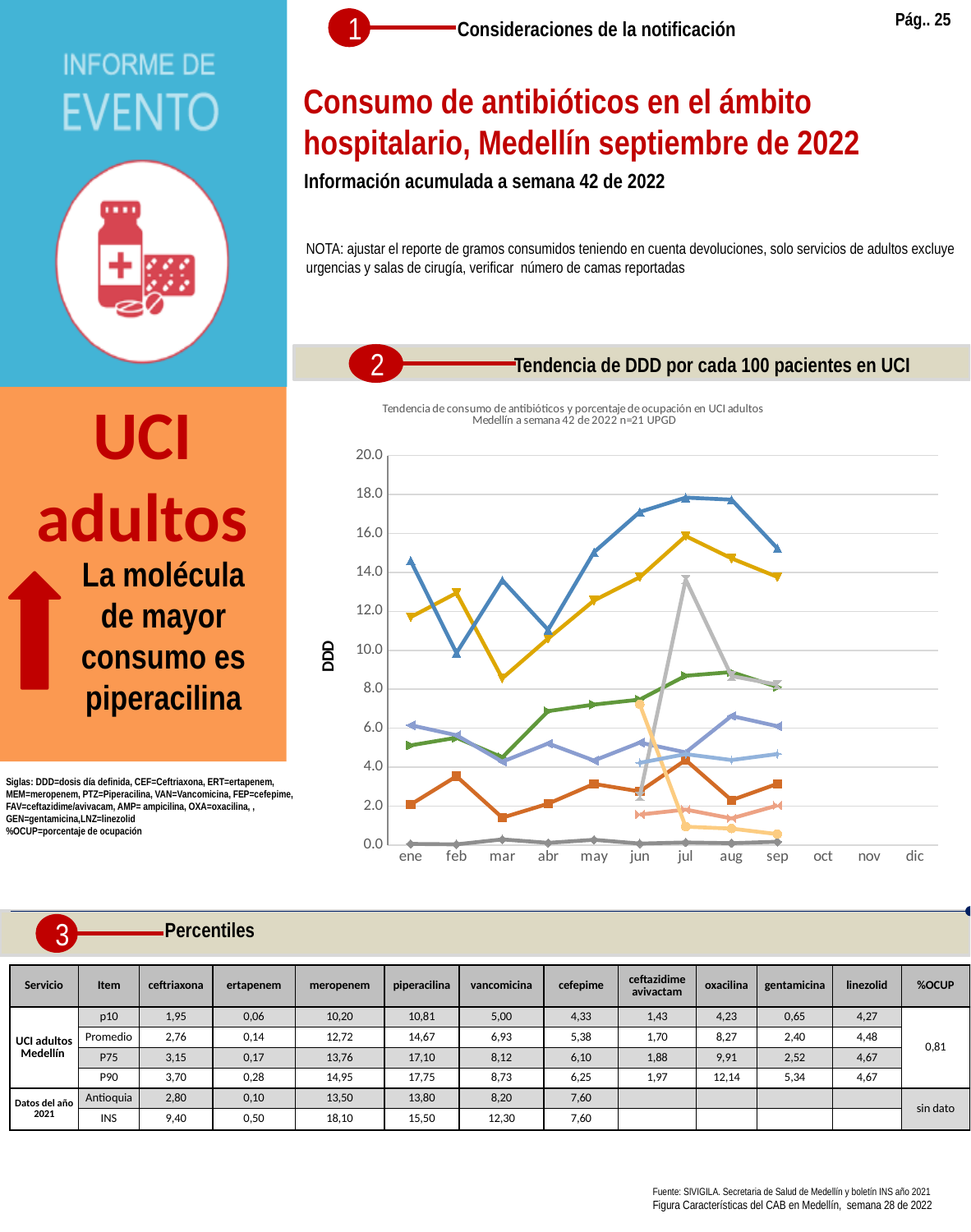
What is the last month for which the line chart has plotted data? sep Is the highest value plotted in the line chart in feb greater or less than 14.0? less What is the highest tick value shown on the y axis of the line chart? 20.0 What is the last month shown on the x axis of the line chart? dic What is the label on the y axis of the line chart? DDD What is the title of the line chart? Tendencia de consumo de antibióticos y porcentaje de ocupación en UCI adultos Medellín a semana 42 de 2022 n=21 UPGD How many months are listed along the x axis of the line chart? 12 How many months on the x axis of the line chart have no plotted data? 3 What kind of chart is shown under the heading 'Tendencia de DDD por cada 100 pacientes en UCI'? line chart Is the highest value plotted in the line chart in jul greater or less than 16.0? greater What is the first month shown on the x axis of the line chart? ene